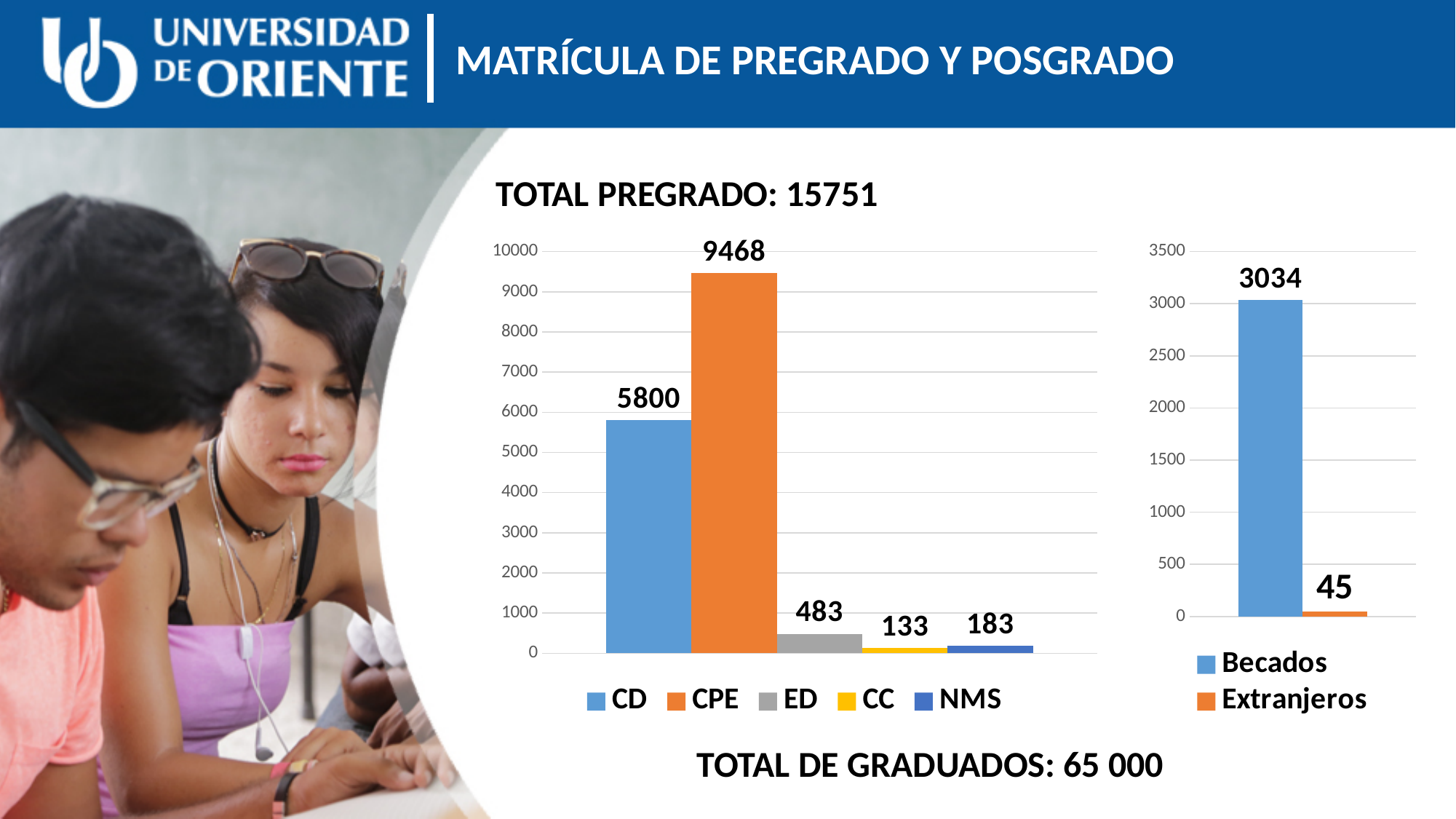
How many series does the legend of the left chart list? 5 In the right chart, what is the difference between the values for Becados and Extranjeros? 2989 In the right chart, what is the value for Extranjeros? 45 In the left chart, which category has the lowest value? CC In the left chart, what is the value for CPE? 9468 In the left chart, which category has the highest value? CPE What kind of chart is the right chart? Bar chart In the left chart, what is the value for CD? 5800 In the left chart, what is the difference between the values for CPE and CD? 3668 In the left chart, which is larger, the value for ED or the value for NMS? ED In the right chart, what is the value for Becados? 3034 In the left chart, what is the value for NMS? 183